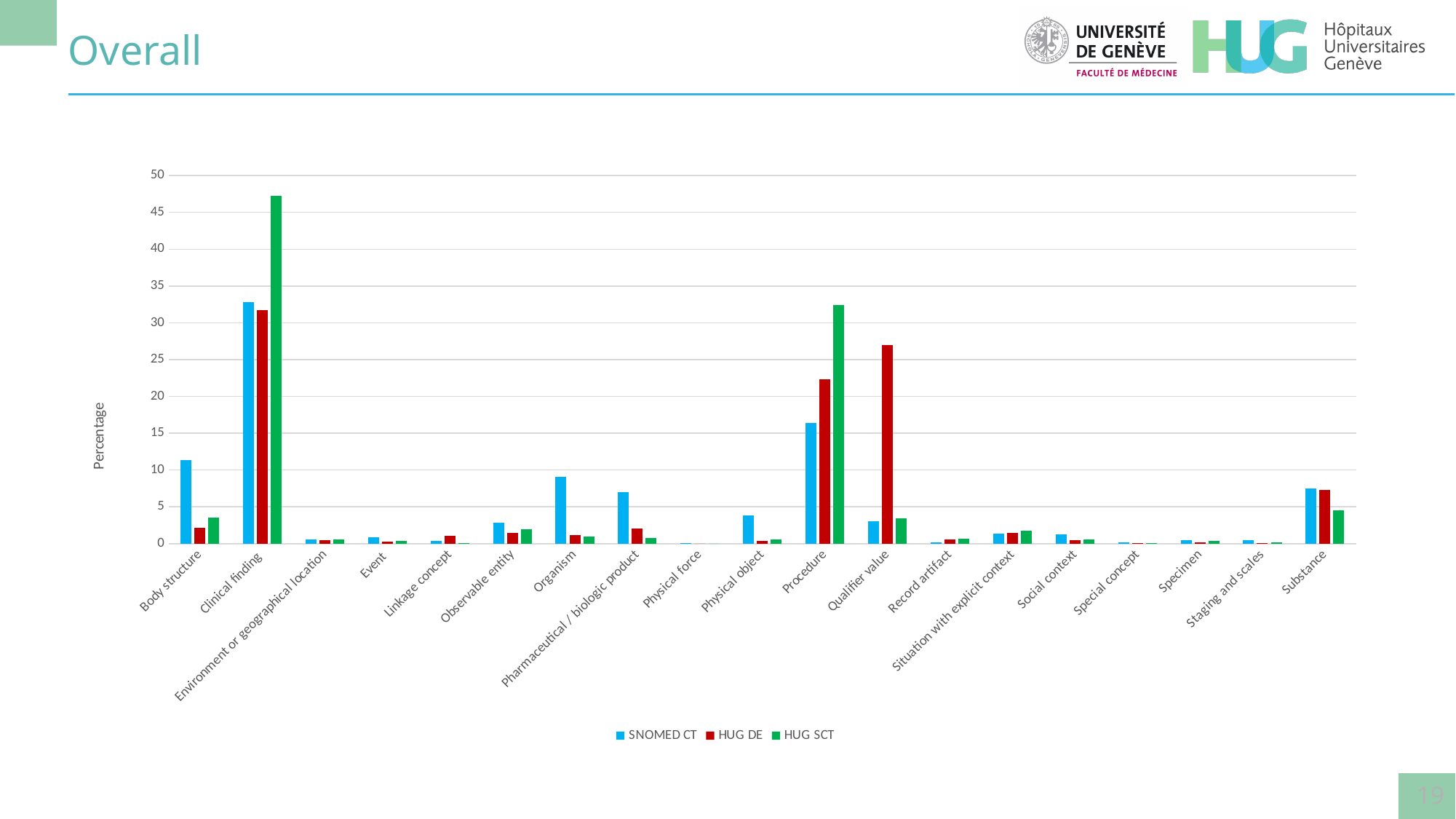
Is the SNOMED CT value for Procedure greater or less than 20? less Is the HUG SCT value for Clinical finding greater or less than 45? greater Which category has the highest HUG DE value? Clinical finding What is the label of the y axis? Percentage Is the HUG DE value for Qualifier value greater or less than 25? greater What kind of chart is shown on the slide? bar chart Which category has the highest SNOMED CT value? Clinical finding For Procedure, which series has the larger value, HUG SCT or SNOMED CT? HUG SCT For Body structure, which series has the larger value, SNOMED CT or HUG DE? SNOMED CT How many series does the legend list? 3 How many categories are shown on the x axis? 19 Which category has the highest HUG SCT value? Clinical finding